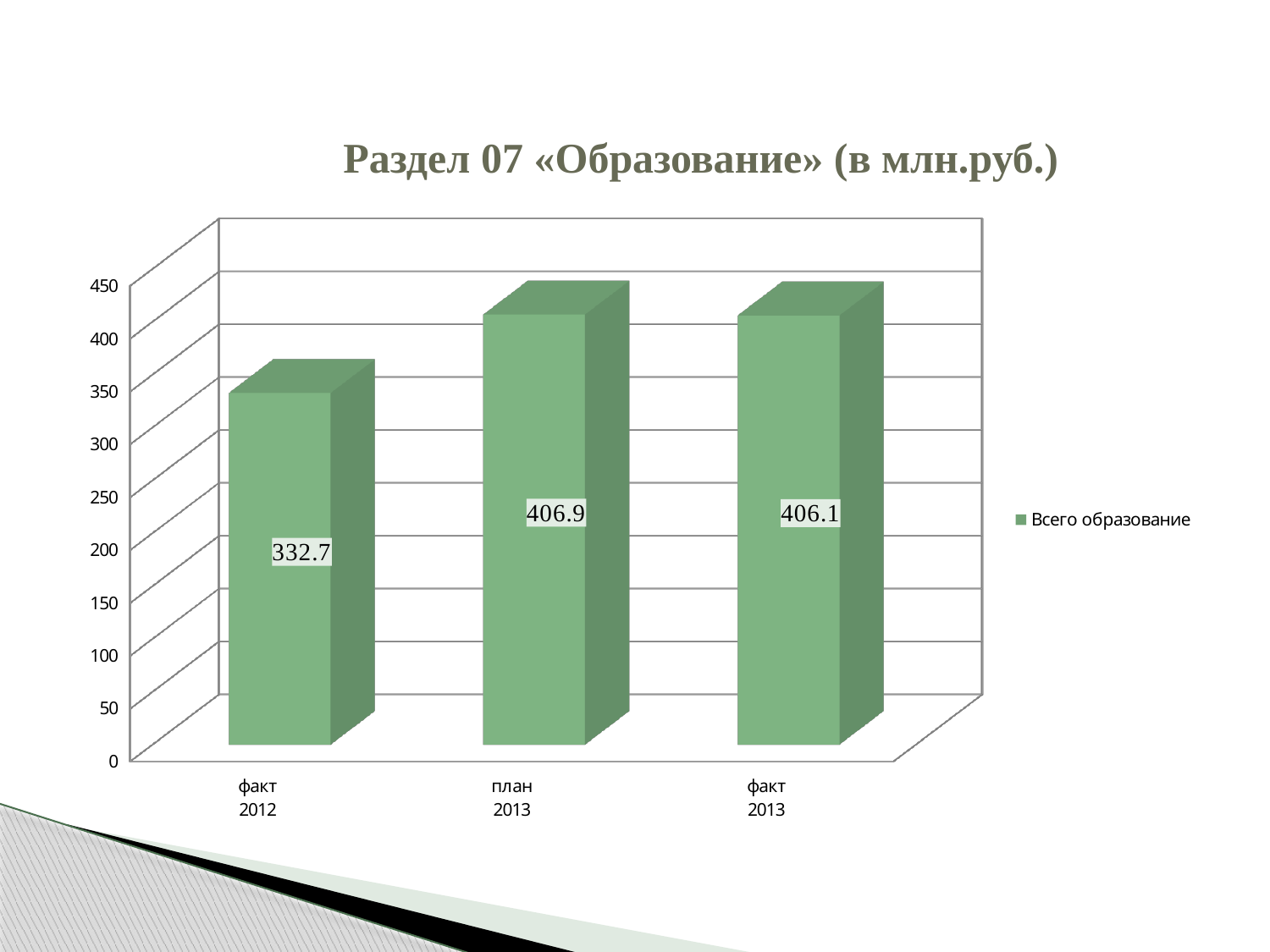
What kind of chart is shown? bar chart Which category has the lowest value? факт 2012 What is the difference between план 2013 and факт 2012? 74.2 What is the value for факт 2013? 406.1 How many series does the legend list? 1 How many categories are shown on the x axis? 3 Which is larger, факт 2012 or факт 2013? факт 2013 What is the difference between план 2013 and факт 2013? 0.8 What is the value for факт 2012? 332.7 What is the title of the chart? Раздел 07 «Образование» (в млн.руб.) Is the value for факт 2012 greater or less than 350? less What is the value for план 2013? 406.9